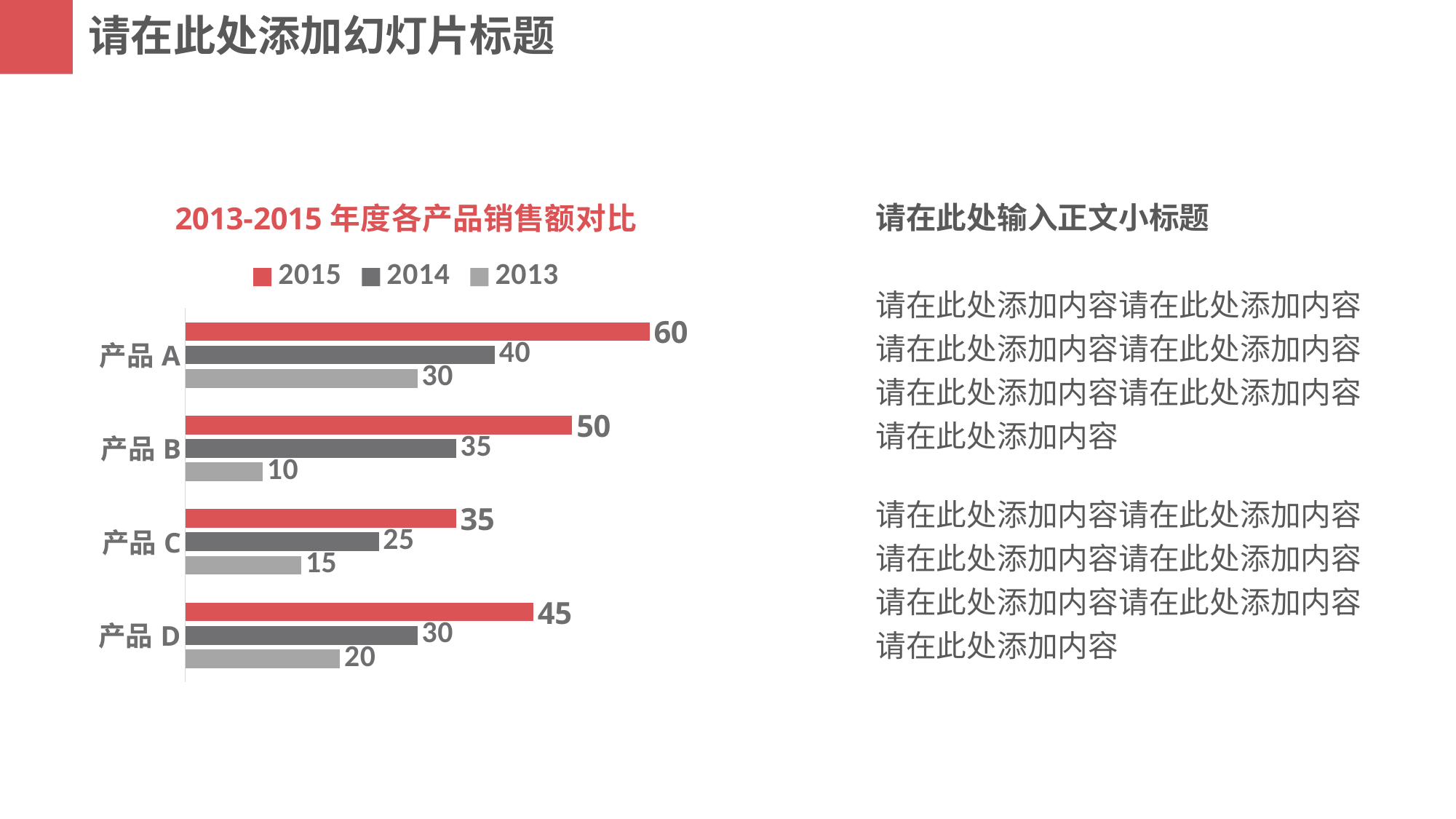
What is the title of the chart? 2013-2015 年度各产品销售额对比 Which is larger, the 2014 value for 产品 A or the 2015 value for 产品 C? 2014 value for 产品 A What kind of chart is shown? Bar chart How many series does the legend list? 3 What is the 2013 value for 产品 B? 10 Which product has the highest 2015 value? 产品 A Which product has the lowest 2013 value? 产品 B Which series is shown in red? 2015 What is the 2014 value for 产品 C? 25 How many products are shown on the chart? 4 What is the 2015 value for 产品 A? 60 What is the difference between the 2015 and 2014 values for 产品 B? 15